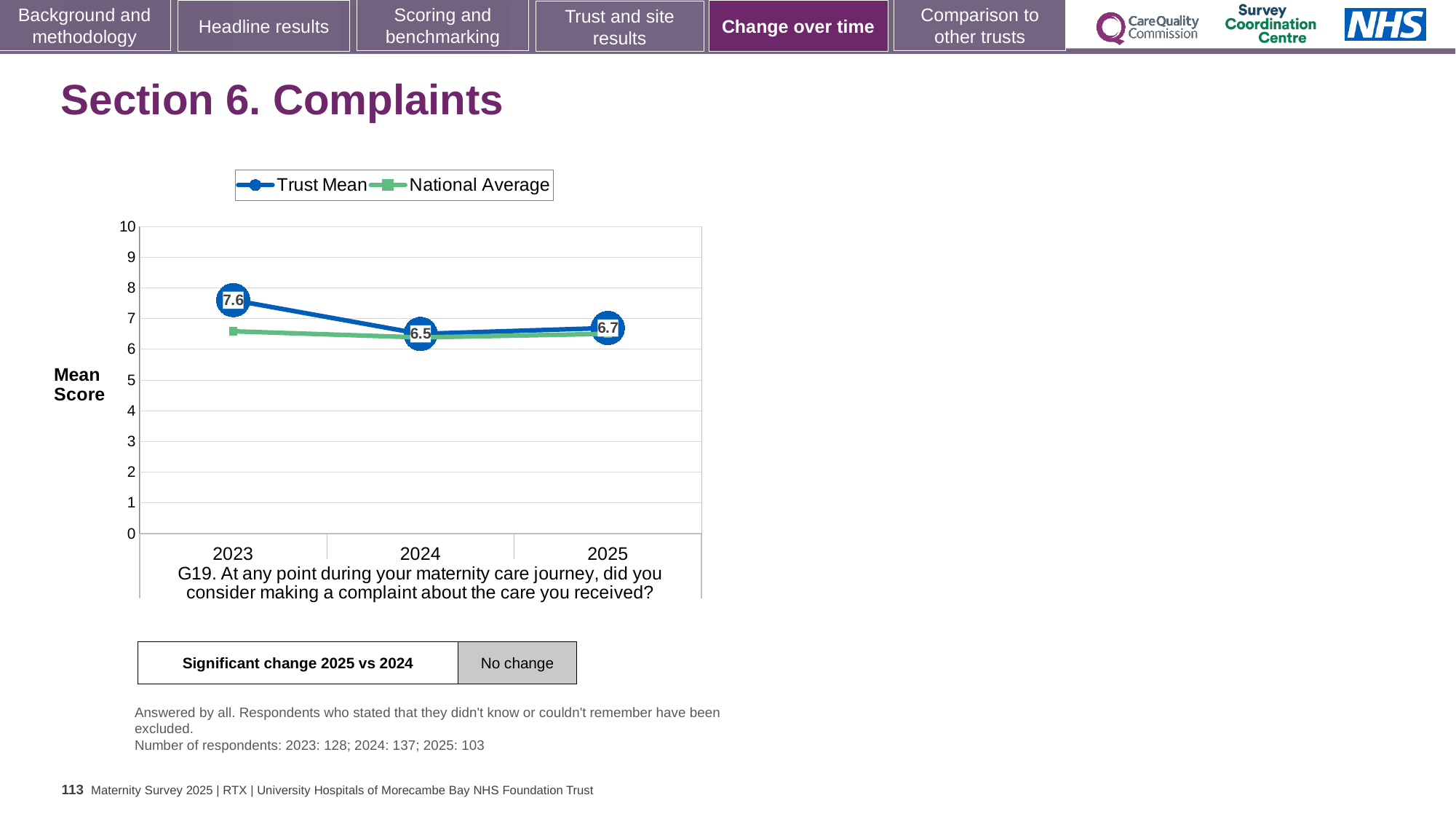
What is the difference between the Trust Mean score in 2025 and in 2024? 0.2 What is the Trust Mean score for 2025? 6.7 What is the Trust Mean score for 2024? 6.5 What is the Trust Mean score for 2023? 7.6 How many years are shown on the x axis? 3 In 2023, which is larger: the Trust Mean or the National Average? Trust Mean In which year is the Trust Mean score highest? 2023 What kind of chart is shown on the slide? line chart In which year is the Trust Mean score lowest? 2024 How many series does the legend list? 2 Is the National Average value for 2023 greater or less than 7? less What is the difference between the Trust Mean score in 2023 and in 2024? 1.1